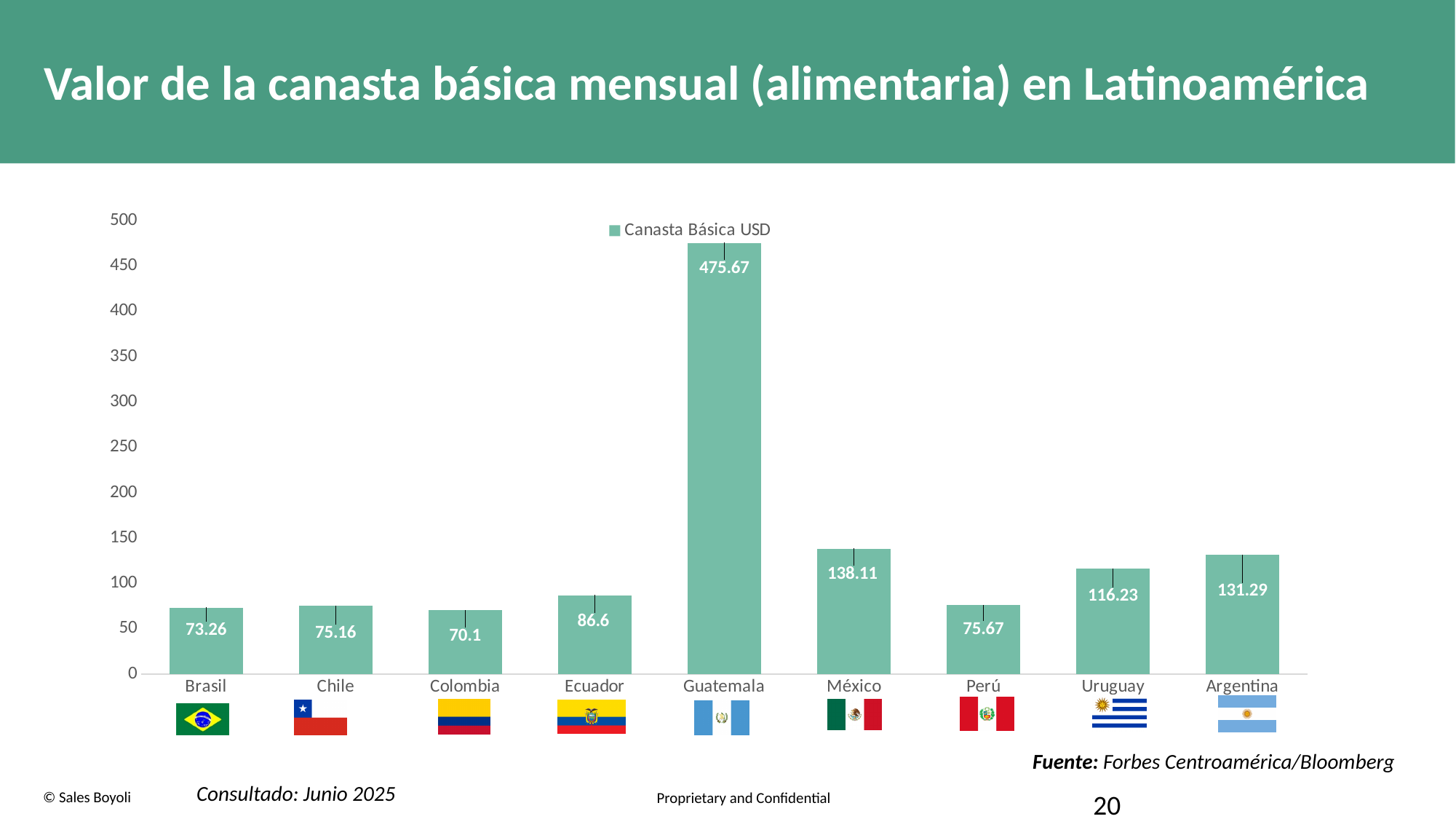
What is the difference between the values for Argentina and Uruguay? 15.06 Which is larger, the value for Ecuador or the value for Perú? Ecuador What is the value for Guatemala? 475.67 Is the value for Uruguay greater or less than 100? greater What is the value for México? 138.11 How many countries are shown on the chart? 9 Which country has the highest value? Guatemala What kind of chart is shown? bar chart What is the legend entry for the series? Canasta Básica USD What is the value for Colombia? 70.1 Which country has the lowest value? Colombia How many series does the legend list? 1